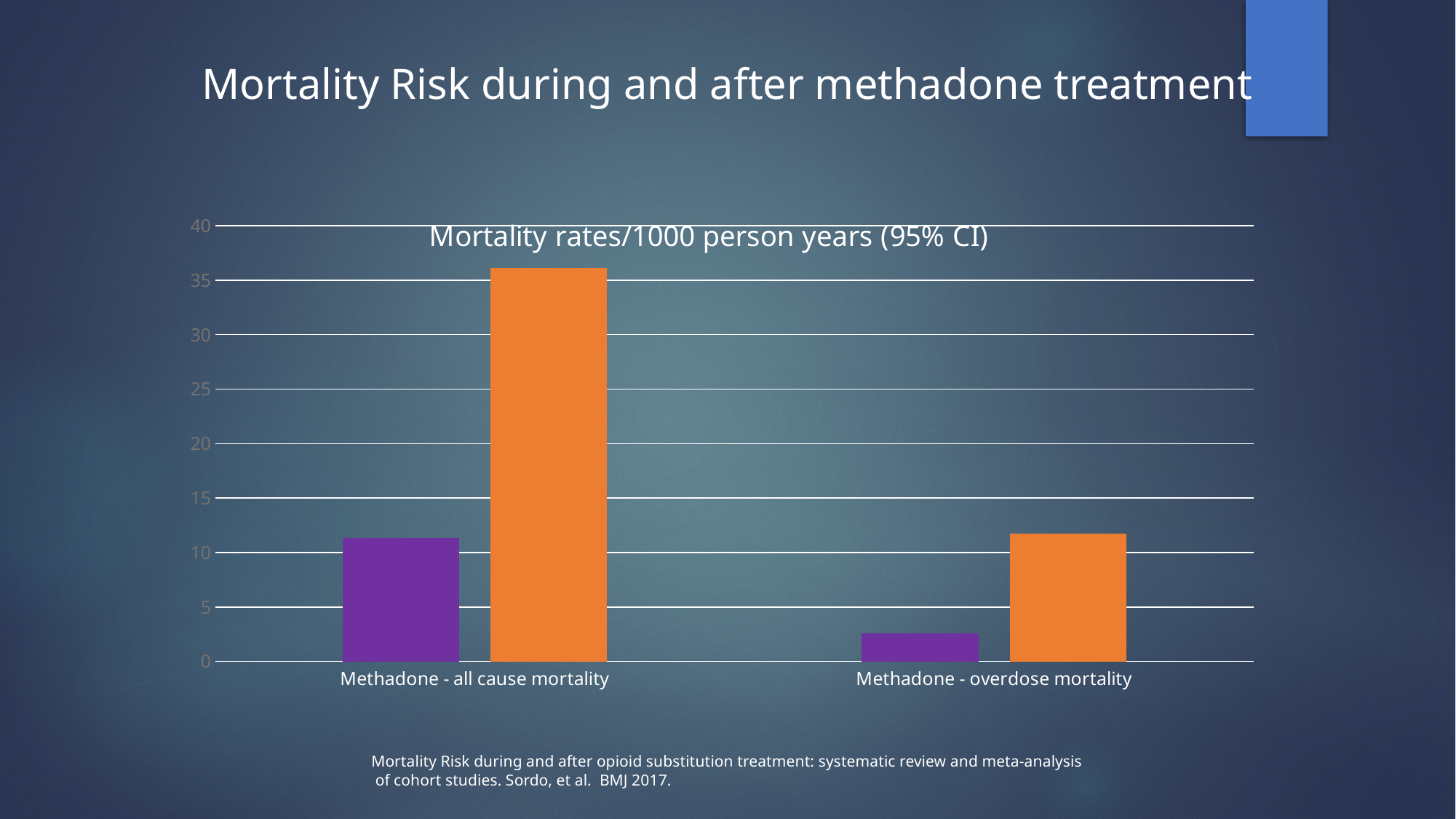
Is the purple bar for Methadone - all cause mortality greater or less than 10? greater How many bars are plotted in the chart? 4 Is the purple bar for Methadone - overdose mortality greater or less than 5? less For Methadone - overdose mortality, which bar is taller, the purple or the orange one? orange Is the orange bar for Methadone - all cause mortality greater or less than 35? greater Which bar is the shortest in the chart? the purple bar for Methadone - overdose mortality How many categories are shown on the x axis of the chart? 2 What is the title of the chart? Mortality rates/1000 person years (95% CI) Which bar is the tallest in the chart? the orange bar for Methadone - all cause mortality What is the highest value shown on the y axis of the chart? 40 What kind of chart is shown on the slide? bar chart